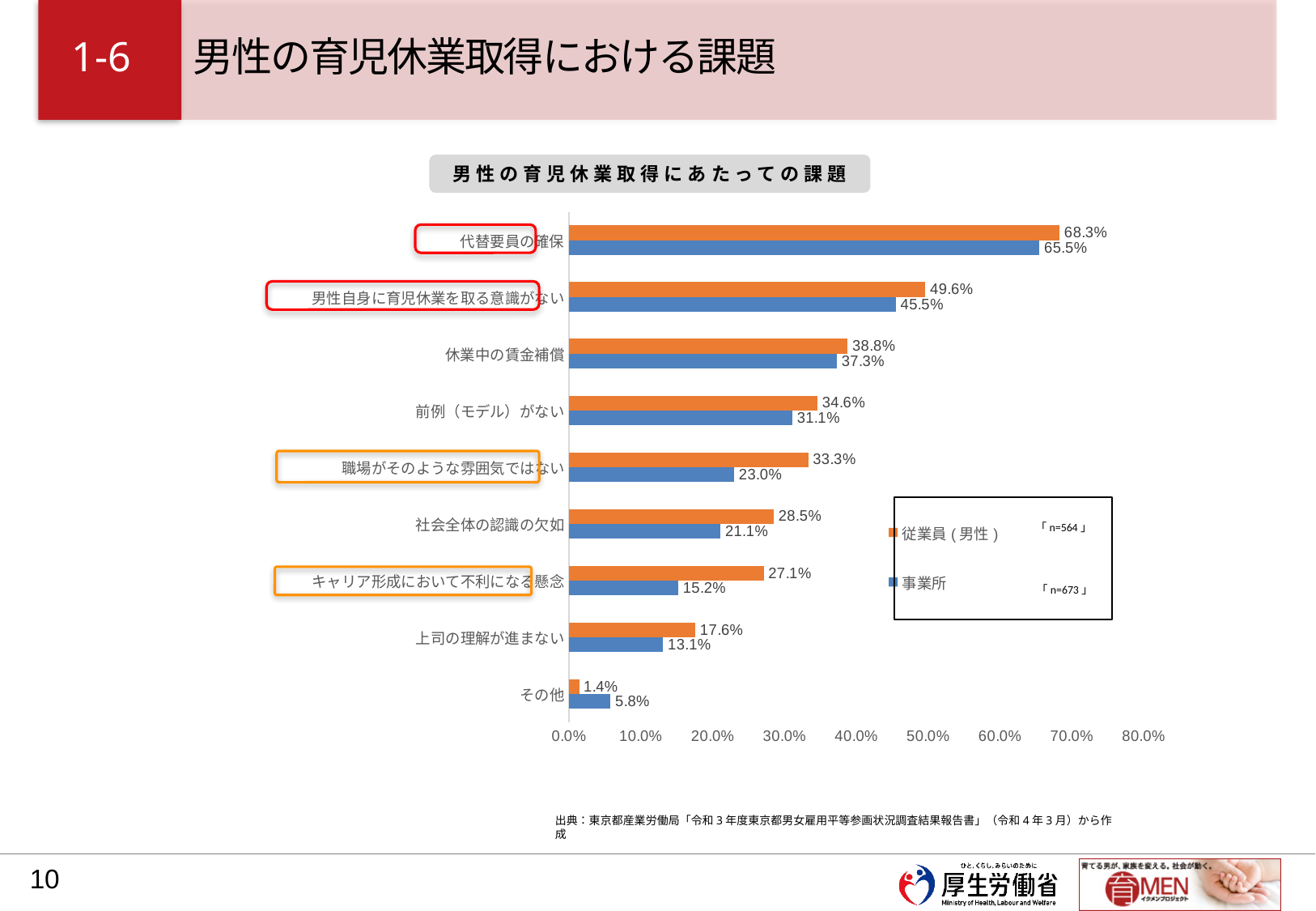
What is the value for 事業所 for キャリア形成において不利になる懸念? 15.2% Which category has the lowest value for 事業所? その他 What is the value for 事業所 for 男性自身に育児休業を取る意識がない? 45.5% What is the title of the chart? 男性の育児休業取得にあたっての課題 What is the value for 従業員(男性) for 代替要員の確保? 68.3% What is the difference between the 従業員(男性) and 事業所 values for 職場がそのような雰囲気ではない? 10.3% Which category has the highest value for 従業員(男性)? 代替要員の確保 Is the 従業員(男性) value for 休業中の賃金補償 greater or less than 30.0%? greater What type of chart is shown on the slide? Bar chart How many series does the legend list? 2 For その他, which series has the larger value, 従業員(男性) or 事業所? 事業所 How many categories are plotted in the chart? 9